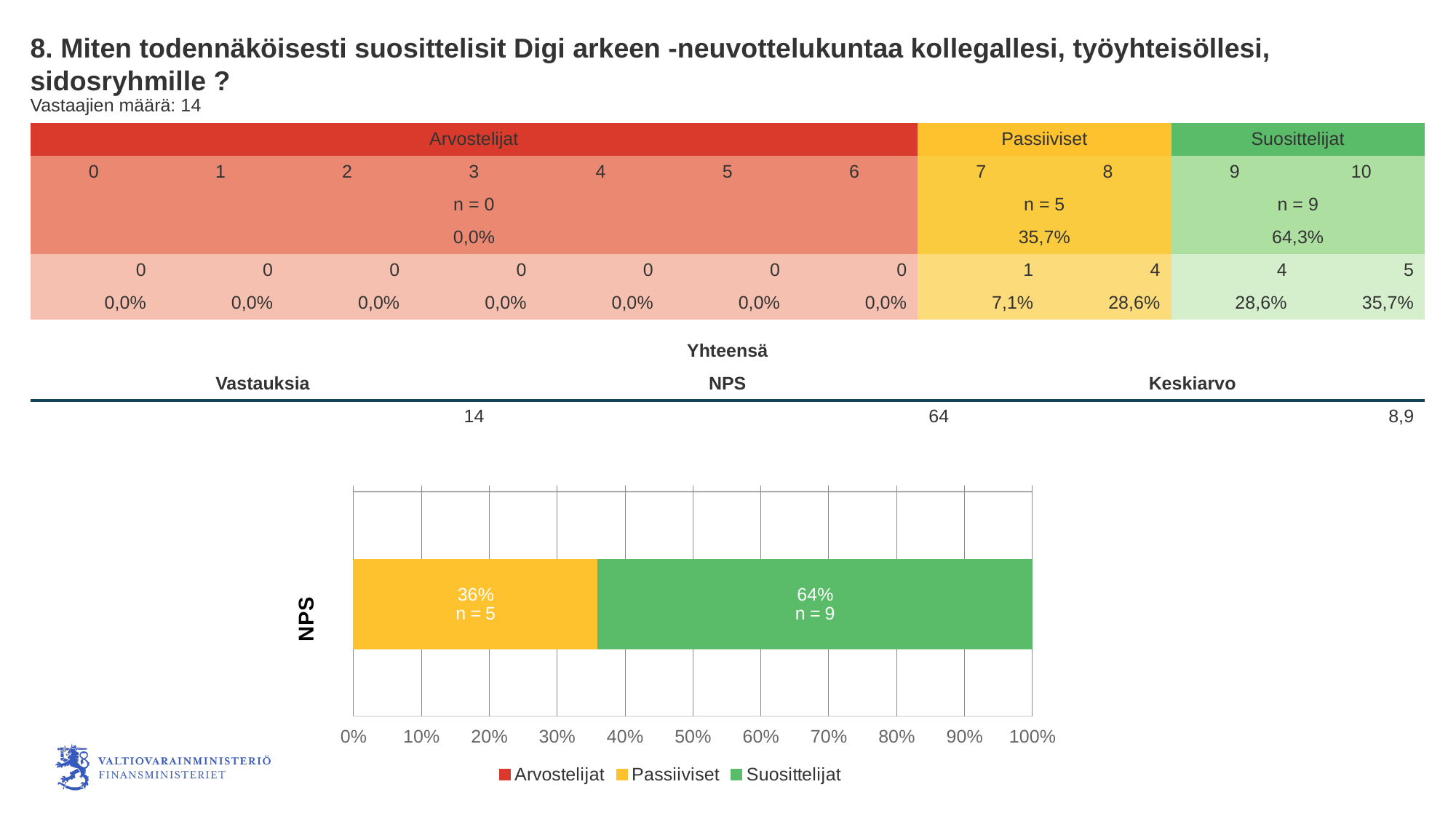
What kind of chart is shown at the bottom of the slide? bar chart What percentage does the Passiiviset segment of the NPS bar show? 36% What is the difference in percentage points between the Suosittelijat and Passiiviset segments of the NPS bar? 28% What is the n value shown in the Passiiviset segment of the NPS bar? n = 5 Which legend entry is shown in green? Suosittelijat What is the total of the Passiiviset and Suosittelijat segments of the NPS bar? 100% How many series does the chart legend list? 3 What is the n value shown in the Suosittelijat segment of the NPS bar? n = 9 Is the Passiiviset segment of the NPS bar greater or less than 40%? less What percentage does the Suosittelijat segment of the NPS bar show? 64% Which segment of the NPS bar is larger, Passiiviset or Suosittelijat? Suosittelijat How many categories are plotted on the chart's vertical axis? 1